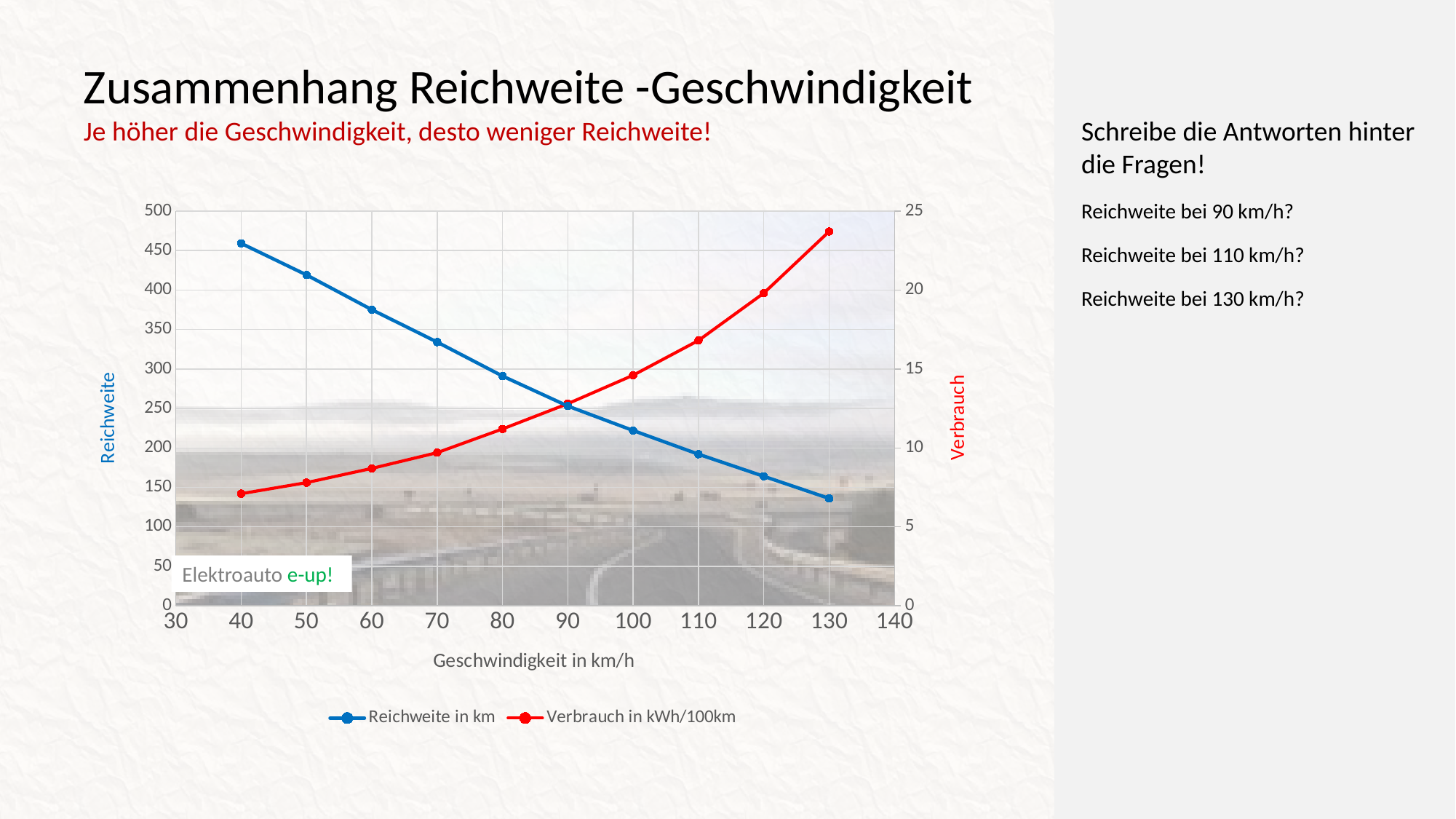
At which speed is the Reichweite in km lowest? 130 Is the Reichweite in km at 40 km/h greater or less than 400? greater Is the Verbrauch in kWh/100km at 130 km/h greater or less than 20? greater At which speed is the Verbrauch in kWh/100km highest? 130 What kind of chart is shown on the slide? line chart What is the title of the x axis of the chart? Geschwindigkeit in km/h Does the Reichweite in km rise or fall as the speed increases along the x axis? fall At which speed is the Reichweite in km highest? 40 Is the Reichweite in km at 130 km/h greater or less than 150? less Does the Verbrauch in kWh/100km rise or fall as the speed increases along the x axis? rise How many series does the chart legend list? 2 How many data points does the Reichweite in km series have? 10